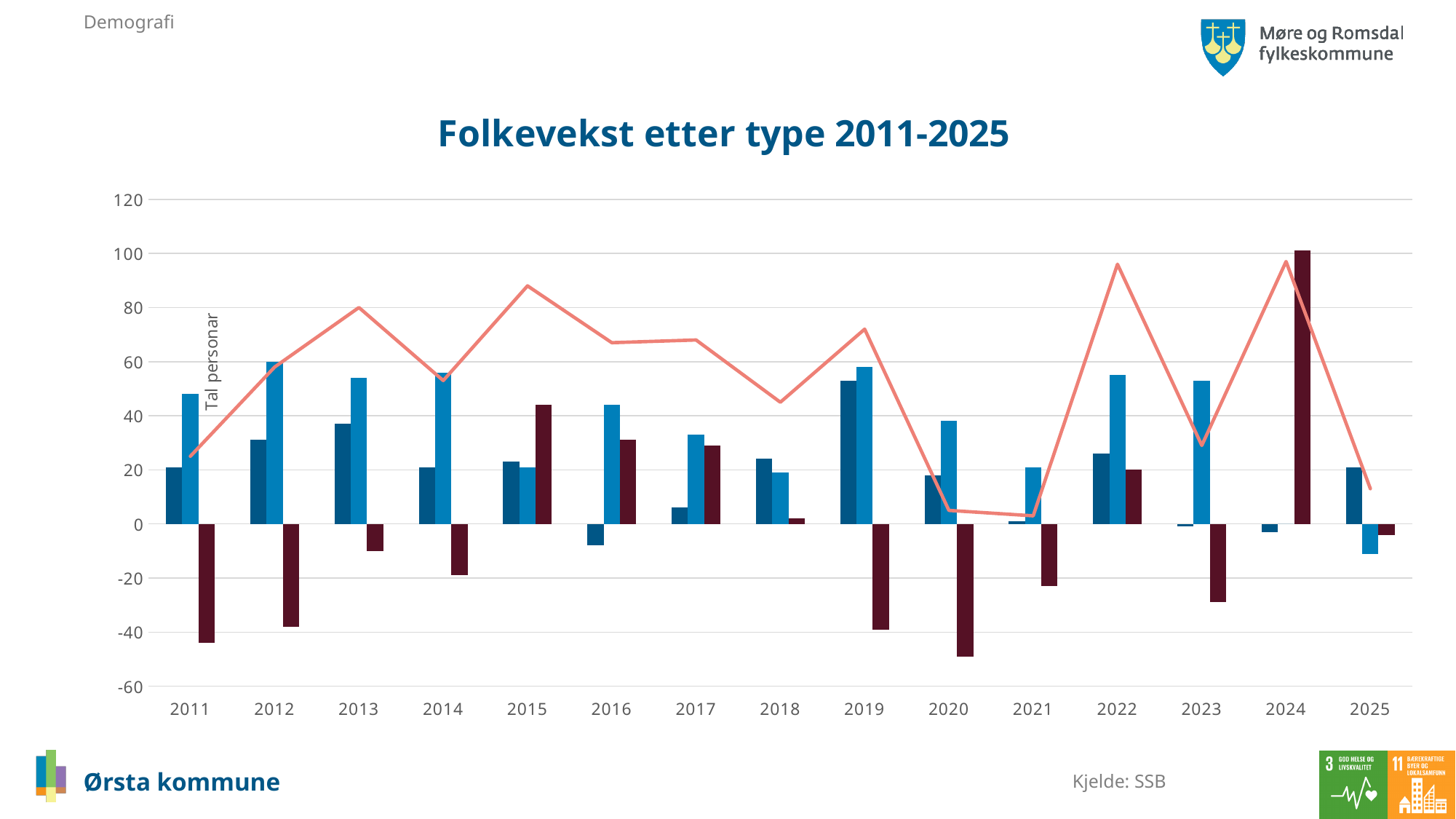
What is the title of the chart? Folkevekst etter type 2011-2025 Which year has the larger light blue bar, 2019 or 2020? 2019 What type of chart is shown on the slide? Bar chart combined with a line Is the value of the light blue bar in 2025 greater or less than 0? less How many years are shown on the x axis of the chart? 15 In which year is the dark red bar the tallest (highest positive value)? 2024 In which year does the dark red bar reach its lowest (most negative) value? 2020 What is the label on the vertical axis of the chart? Tal personar Does the line rise or fall from 2019 to 2021? fall Is the value of the dark red bar in 2020 greater or less than -40? less Is the value of the line in 2020 greater or less than 20? less